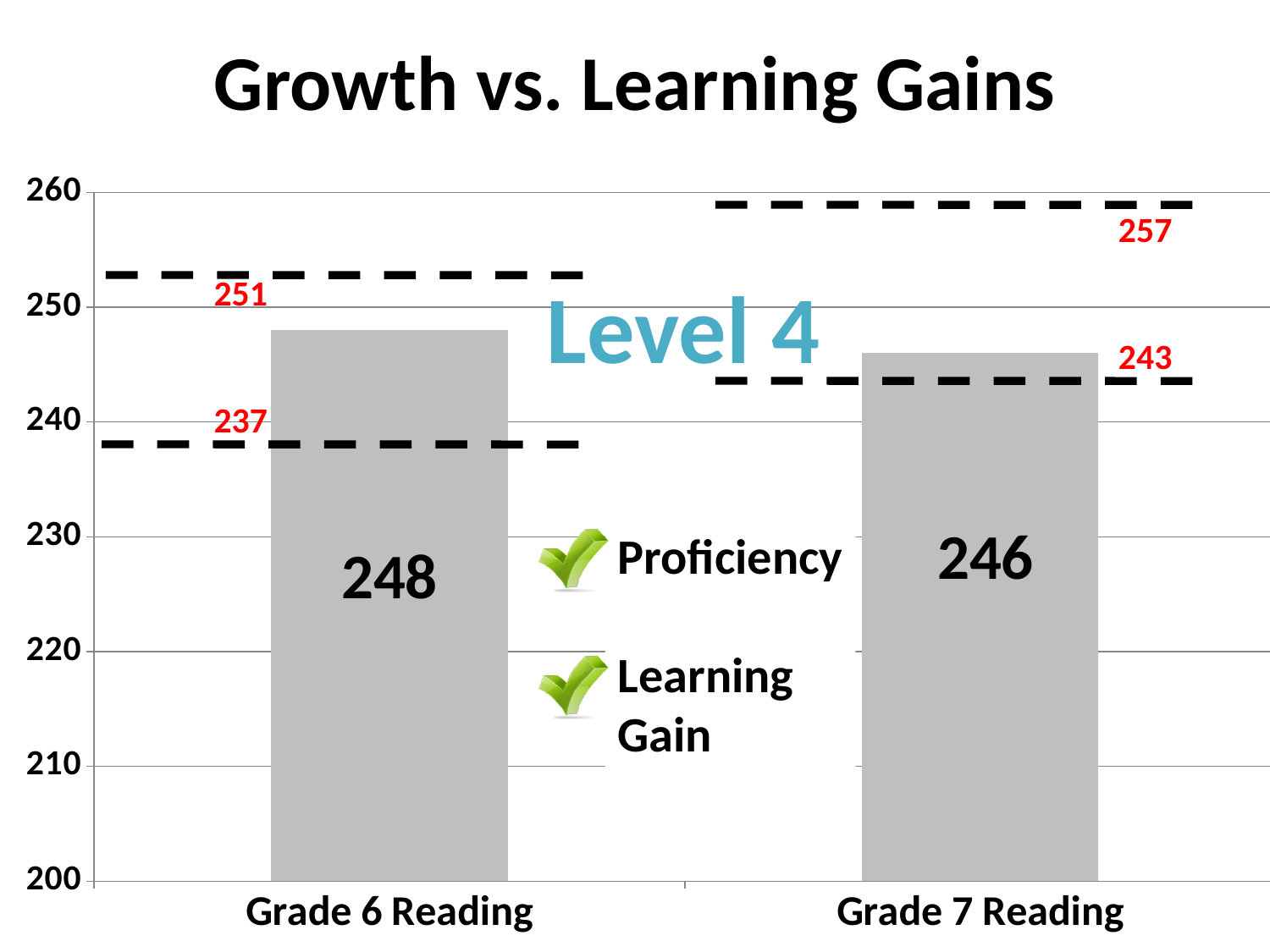
How many categories are shown on the x axis? 2 Do the bar values rise or fall from Grade 6 Reading to Grade 7 Reading? fall Which category has the higher bar? Grade 6 Reading What is the difference between the Grade 6 Reading and Grade 7 Reading values? 2 What is the upper dashed-line value shown for Grade 7 Reading? 257 What is the value for Grade 6 Reading? 248 What is the value for Grade 7 Reading? 246 What kind of chart is shown on the slide? bar chart Is the value for Grade 7 Reading greater or less than 250? less Is the value for Grade 6 Reading greater or less than 240? greater Which category has the lower bar? Grade 7 Reading What is the title of the chart? Growth vs. Learning Gains